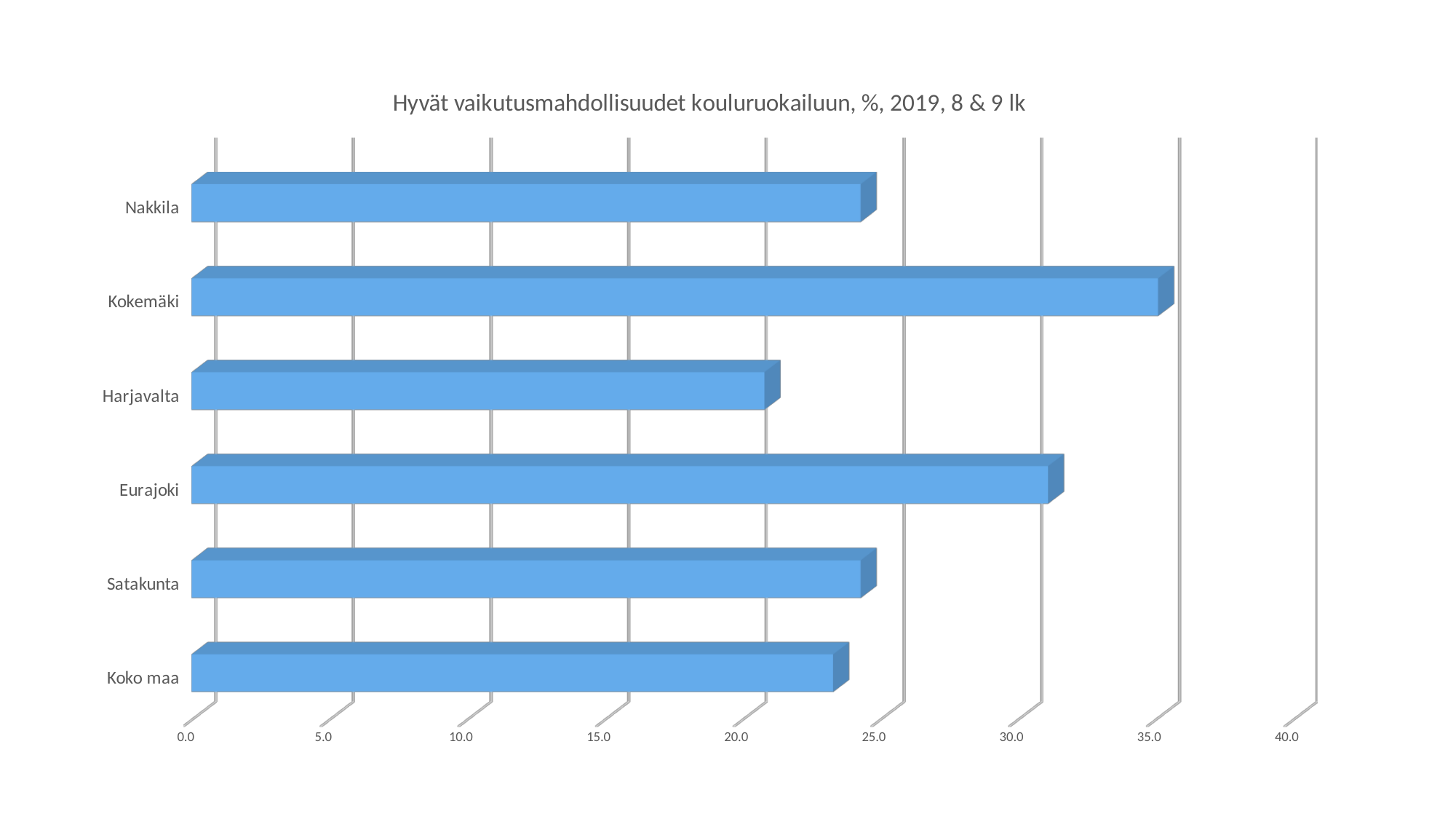
Is the value for Kokemäki greater or less than 30? greater Which has a larger value, Harjavalta or Koko maa? Koko maa Which has a larger value, Kokemäki or Eurajoki? Kokemäki Is the value for Nakkila greater or less than 30? less Is the value for Koko maa greater or less than 20? greater What kind of chart is shown on the slide? bar chart Which category has the highest value? Kokemäki What is the title of the chart? Hyvät vaikutusmahdollisuudet kouluruokailuun, %, 2019, 8 & 9 lk Which category has the lowest value? Harjavalta How many categories are plotted in the chart? 6